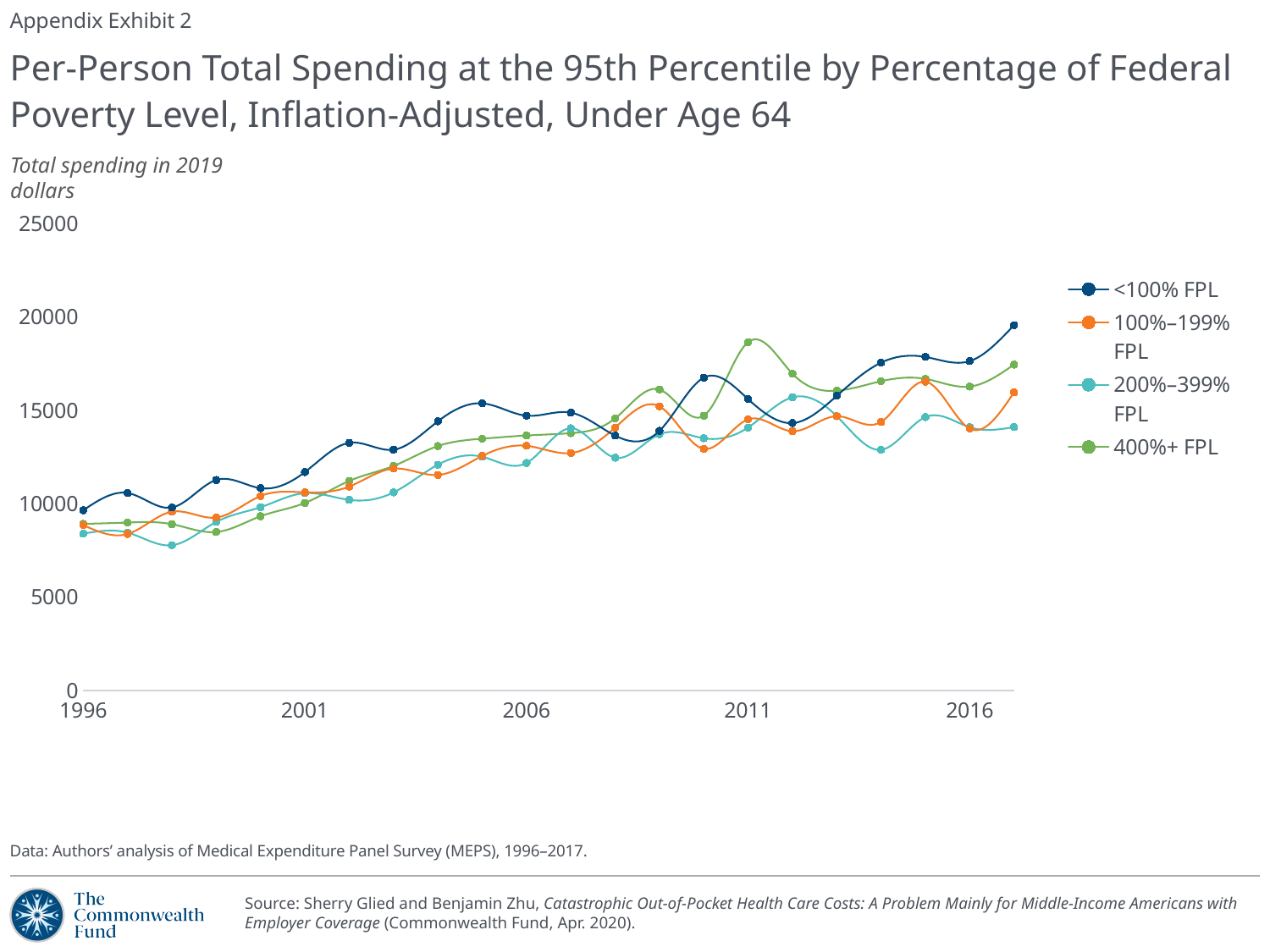
What kind of chart is shown on the slide? line chart Overall, does the <100% FPL series rise or fall from 1996 to 2017? rise Is the value for <100% FPL in 1996 greater or less than 15000? less Which series is lowest at the last point (2017)? 200%–399% FPL What unit does the y-axis label say spending is measured in? Total spending in 2019 dollars Is the value for 200%–399% FPL in 1996 greater or less than 10000? less Which series is highest at the last point (2017)? <100% FPL Is the value for <100% FPL in 2017 greater or less than 15000? greater In 2017, which is larger: the value for <100% FPL or the value for 200%–399% FPL? <100% FPL In 2011, which is larger: the value for 400%+ FPL or the value for <100% FPL? 400%+ FPL How many series does the legend list? 4